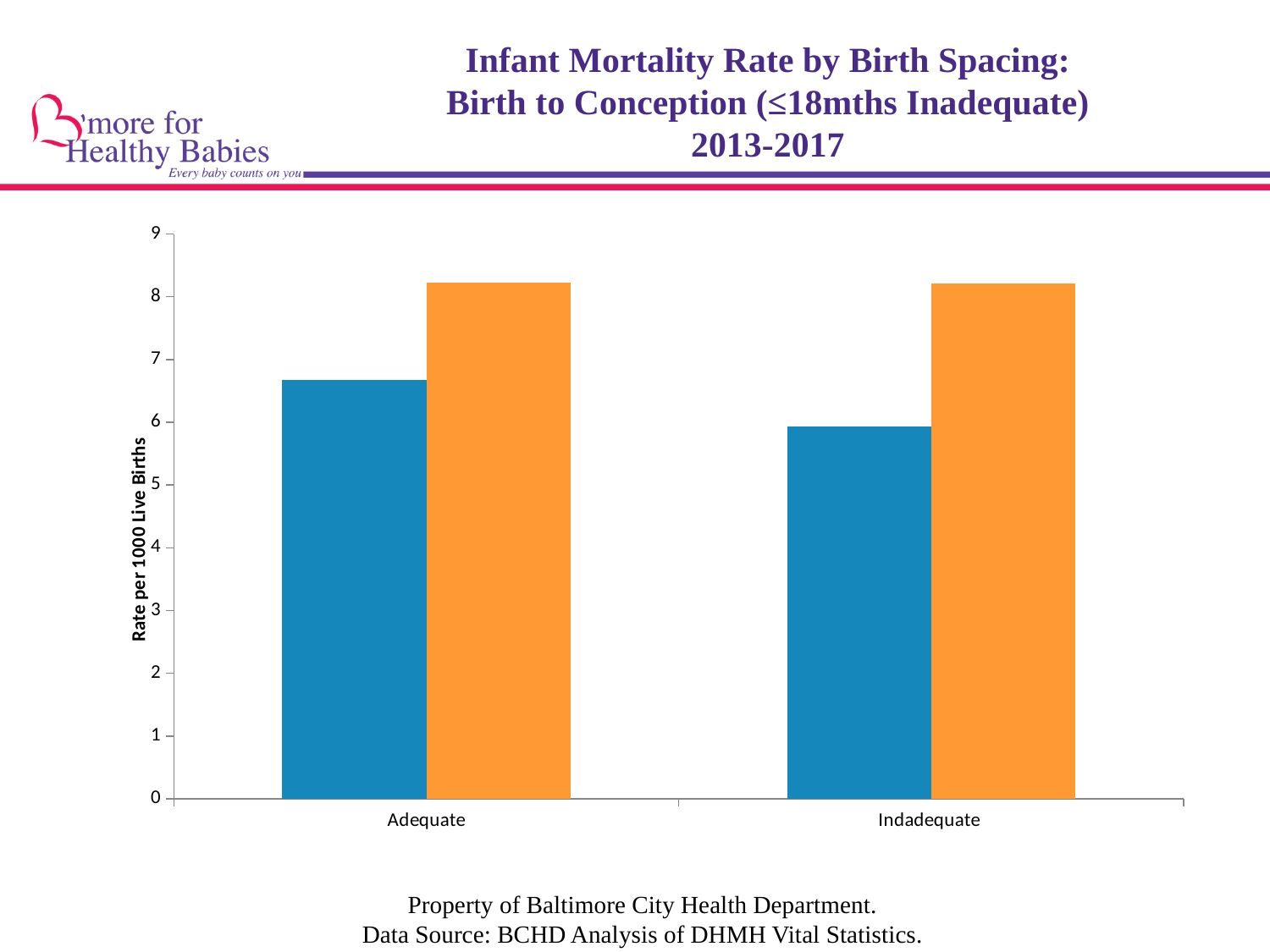
What years does the chart title say the data covers? 2013-2017 What is the label on the y axis of the chart? Rate per 1000 Live Births Is the value of the blue bar for Adequate greater or less than 7? less Is the value of the orange bar for Adequate greater or less than 8? greater How many categories are shown on the x axis of the chart? 2 Which category has the higher blue bar, Adequate or Indadequate? Adequate Within the Indadequate category, which bar is taller, the blue one or the orange one? orange Is the value of the orange bar for Indadequate greater or less than 8? greater How many bars are plotted for the Adequate category? 2 What kind of chart is shown on the slide? bar chart